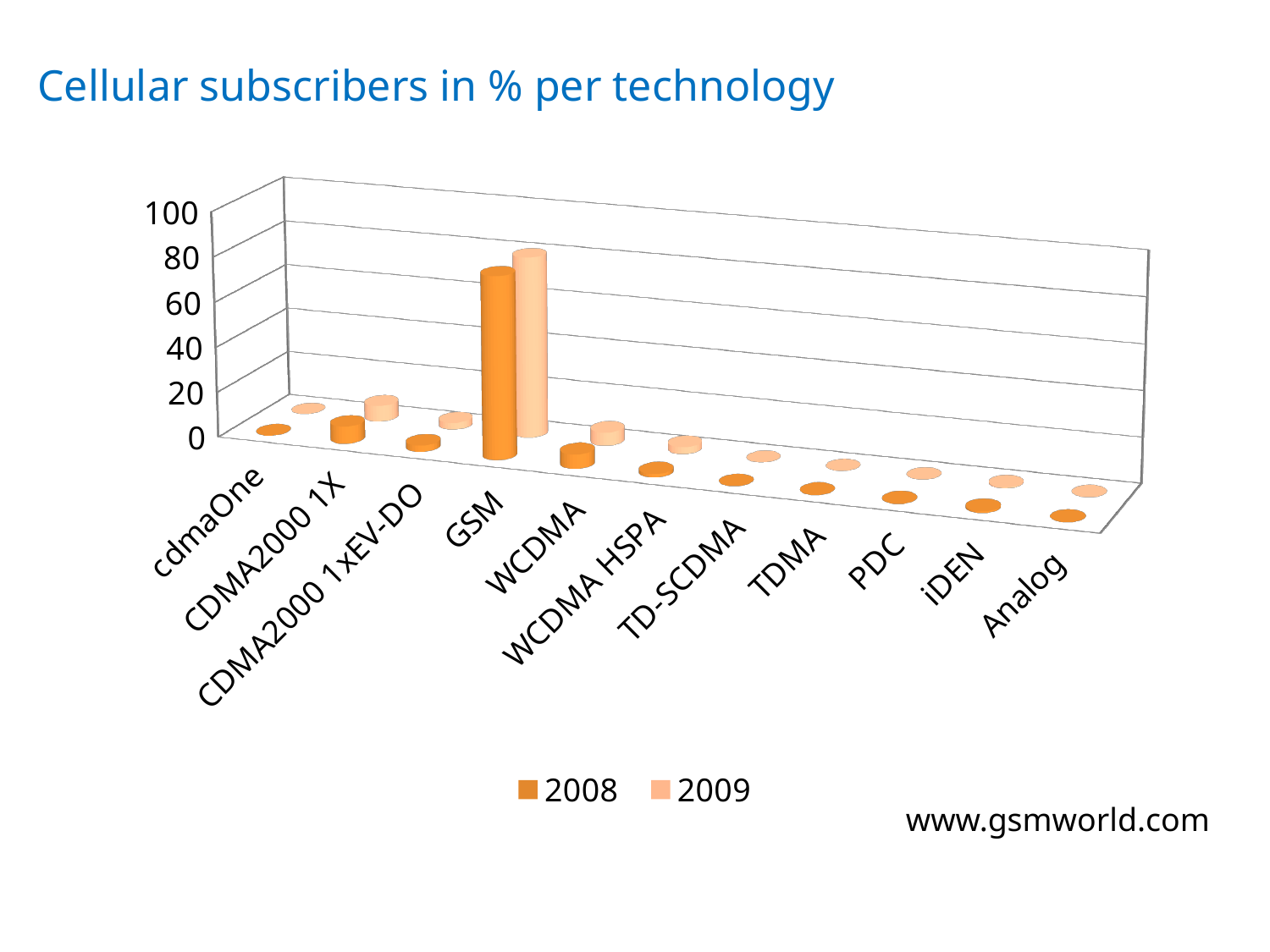
How many technology categories are shown on the x axis? 11 Is the 2008 value for CDMA2000 1X greater or less than 20? less Which is larger, the 2008 value for GSM or the 2008 value for WCDMA? GSM Which technology has the highest share of cellular subscribers in 2009? GSM How many series does the legend list? 2 Which years are listed in the legend? 2008 and 2009 What kind of chart is shown on the slide? bar chart Which technology has the highest share of cellular subscribers in 2008? GSM What is the title of the chart? Cellular subscribers in % per technology Is the 2009 value for GSM greater or less than 60? greater Is the 2008 value for GSM greater or less than 60? greater